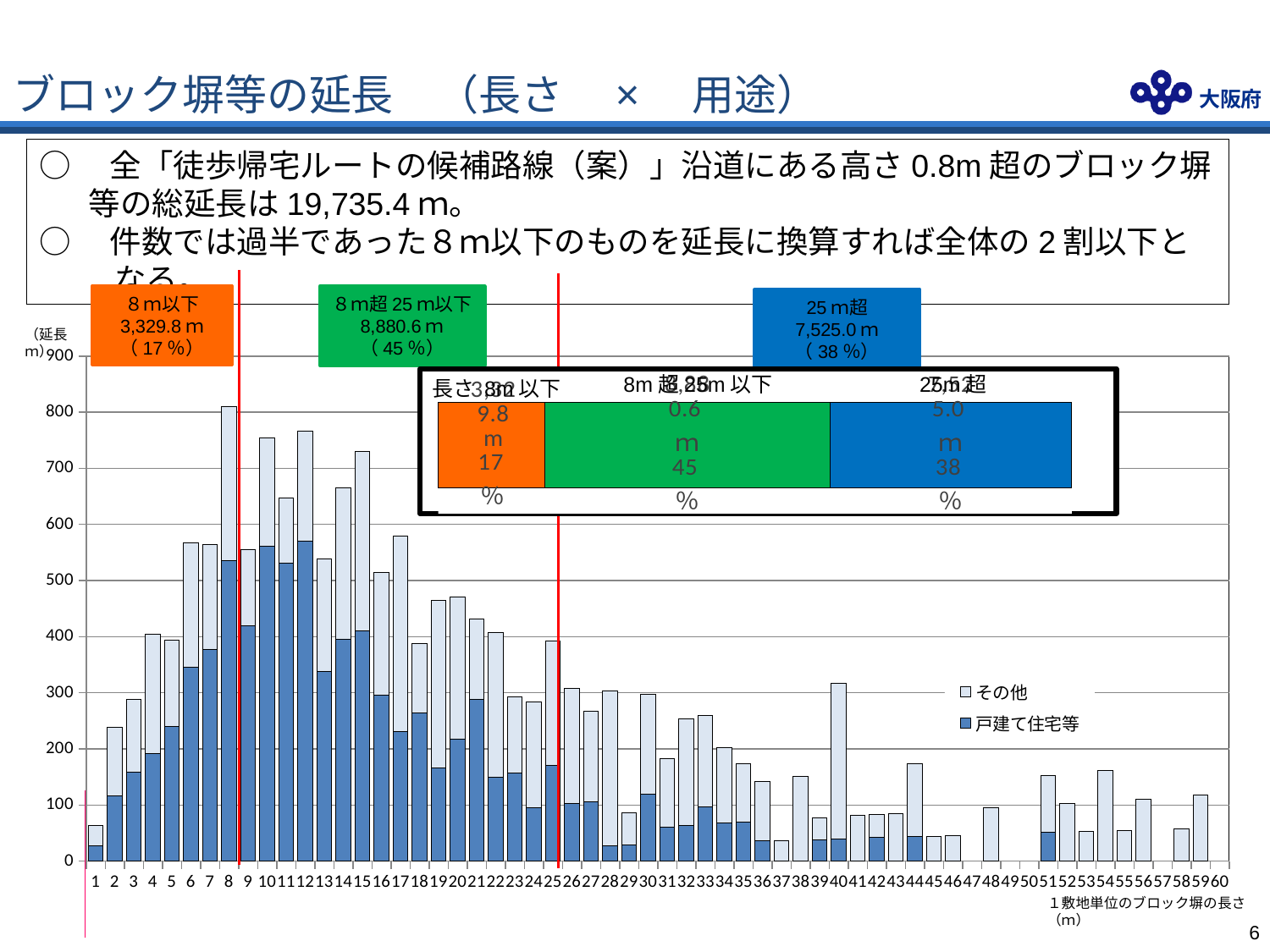
Which x-axis category has the highest total stacked bar in the bar chart? 8 Is the total stacked value for category 10 greater or less than 700? greater How many series does the legend of the bar chart list? 2 Do the total stacked values generally rise or fall from category 1 to category 8? rise What kind of chart is shown on the slide? bar chart In the overlaid summary bar, what total length is given for the 8 m以下 segment? 3,329.8 m What are the two legend entries of the bar chart? その他, 戸建て住宅等 Which has the larger total stacked bar, category 8 or category 9? 8 In the overlaid summary bar, what total length is given for the 25 m超 segment? 7,525.0 m Is the total stacked value for category 37 greater or less than 100? less Is the total stacked value for category 1 greater or less than 100? less In the overlaid summary bar, what share is given for the 8 m超 25 m以下 segment? 45 %